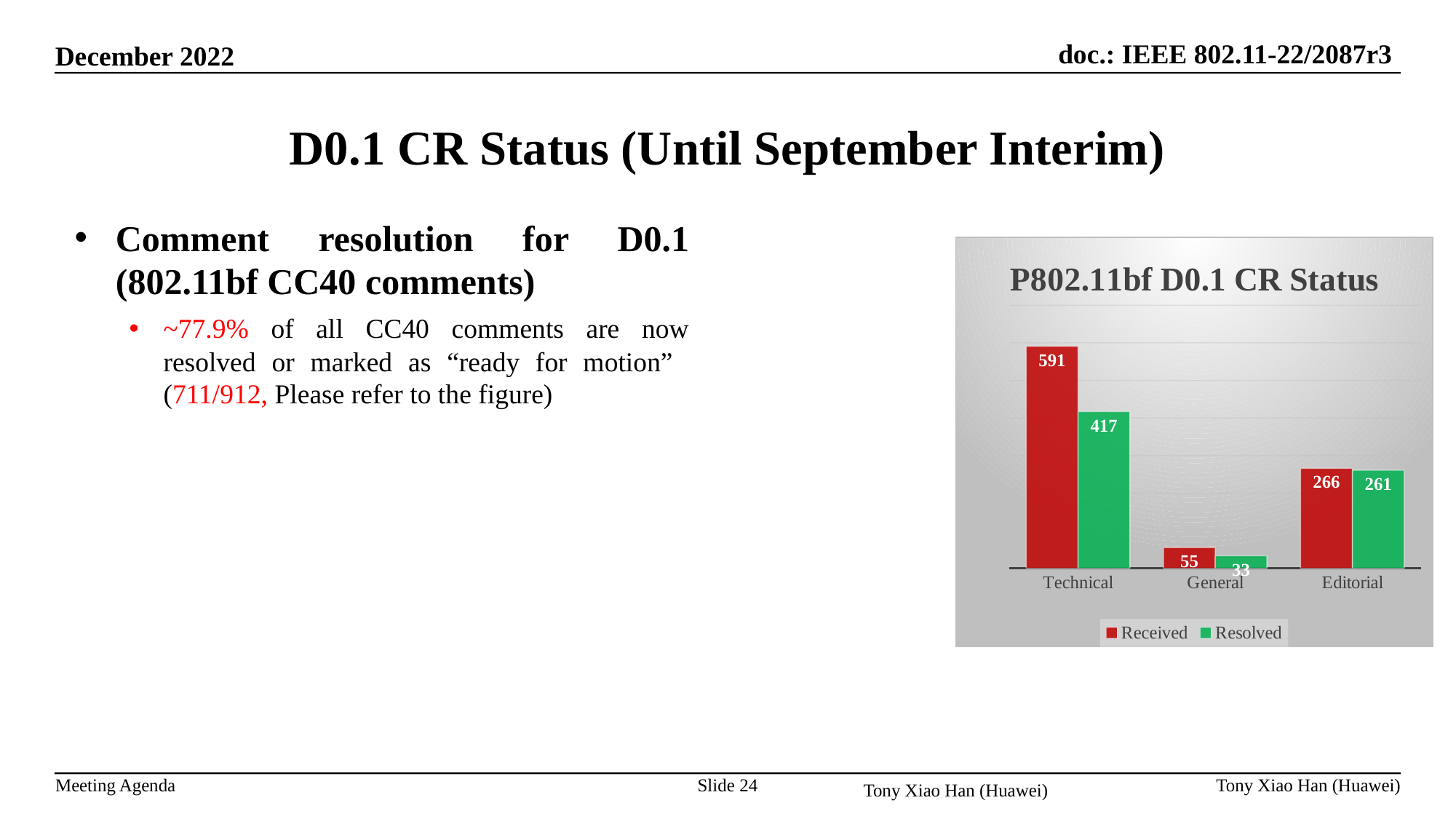
What is the title of the chart? P802.11bf D0.1 CR Status Which is larger, the Resolved value for Technical or the Received value for Editorial? Resolved value for Technical Which category has the lowest Resolved value? General What is the difference between Received and Resolved for General? 22 What is the Resolved value for General? 33 How many series does the legend list? 2 What is the Resolved value for Editorial? 261 Which category has the highest Received value? Technical How many categories are shown on the x axis? 3 What is the Received value for Technical? 591 What is the Received value for General? 55 What is the difference between Received and Resolved for Technical? 174